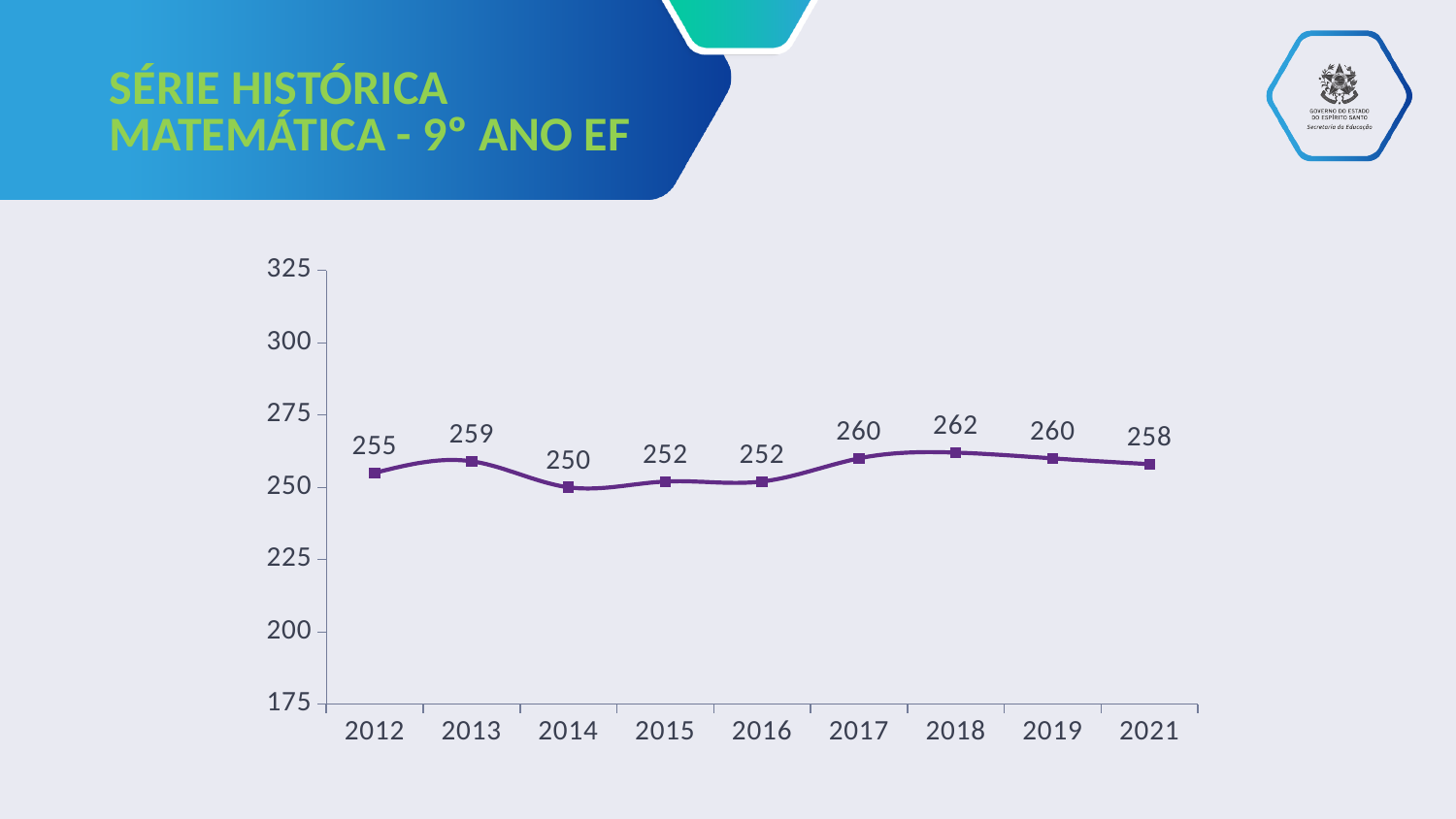
What is the value for 2018? 262 What kind of chart is shown on the slide? line chart What is the value for 2012? 255 What is the difference between the values for 2018 and 2014? 12 What is the value for 2021? 258 Is the value for 2017 greater or less than 250? greater How many years are plotted on the chart? 9 What is the title of the slide? SÉRIE HISTÓRICA MATEMÁTICA - 9º ANO EF Which year has the lowest value? 2014 Does the value rise or fall from 2013 to 2014? fall Which year has the highest value? 2018 Which is larger, the value for 2013 or the value for 2016? 2013